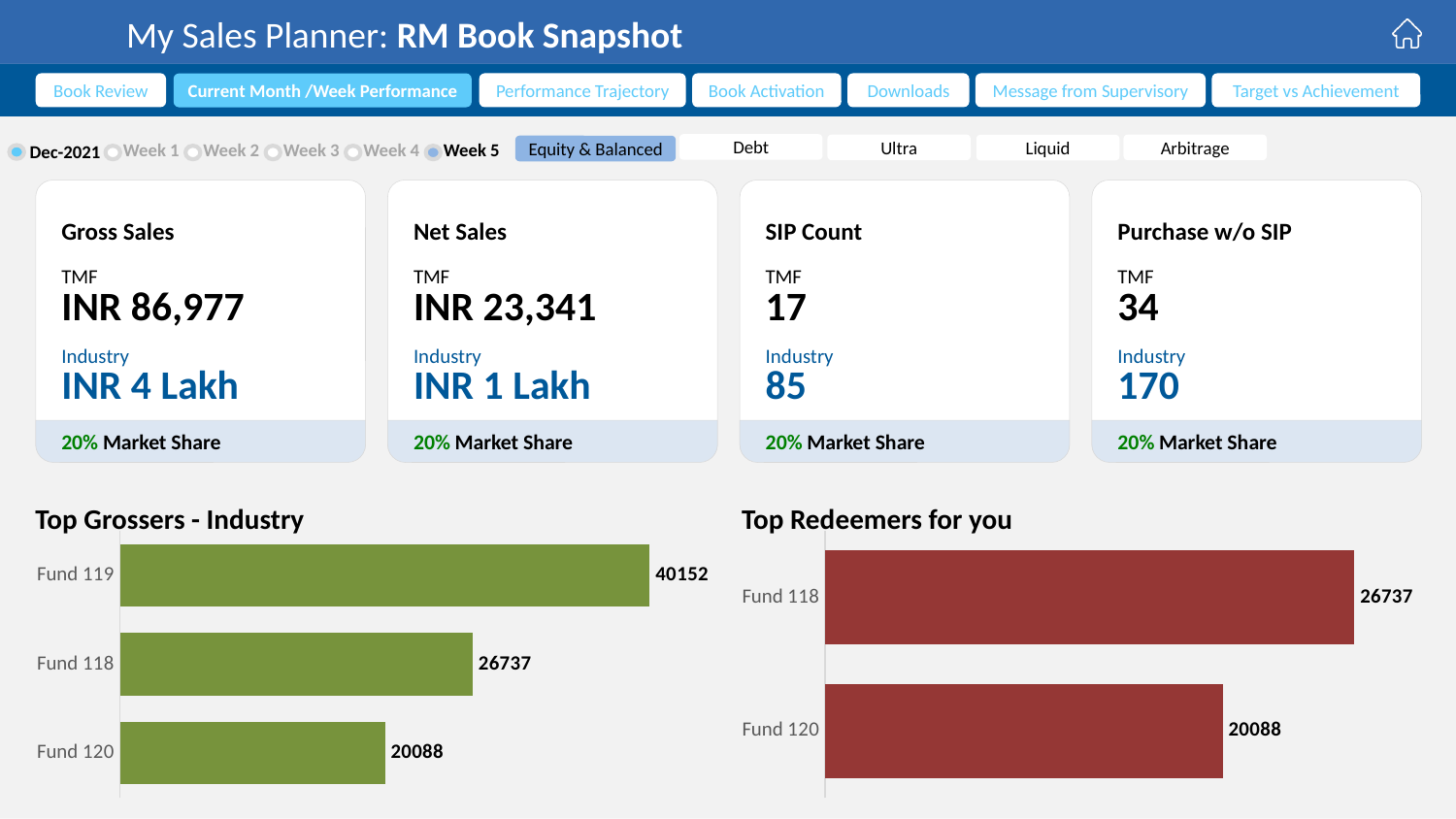
In the 'Top Grossers - Industry' chart, which is larger: the value for Fund 118 or Fund 120? Fund 118 How many funds are shown in the 'Top Redeemers for you' chart? 2 In the 'Top Grossers - Industry' chart, which fund has the highest value? Fund 119 In the 'Top Redeemers for you' chart, what is the value for Fund 118? 26737 In the 'Top Redeemers for you' chart, what is the difference between the values for Fund 118 and Fund 120? 6649 In the 'Top Grossers - Industry' chart, what is the difference between the values for Fund 119 and Fund 118? 13415 In the 'Top Grossers - Industry' chart, which fund has the lowest value? Fund 120 In the 'Top Grossers - Industry' chart, what is the value for Fund 119? 40152 What type of chart is 'Top Redeemers for you'? Bar chart How many funds are shown in the 'Top Grossers - Industry' chart? 3 In the 'Top Redeemers for you' chart, which fund has the lower value? Fund 120 In the 'Top Grossers - Industry' chart, what is the value for Fund 120? 20088